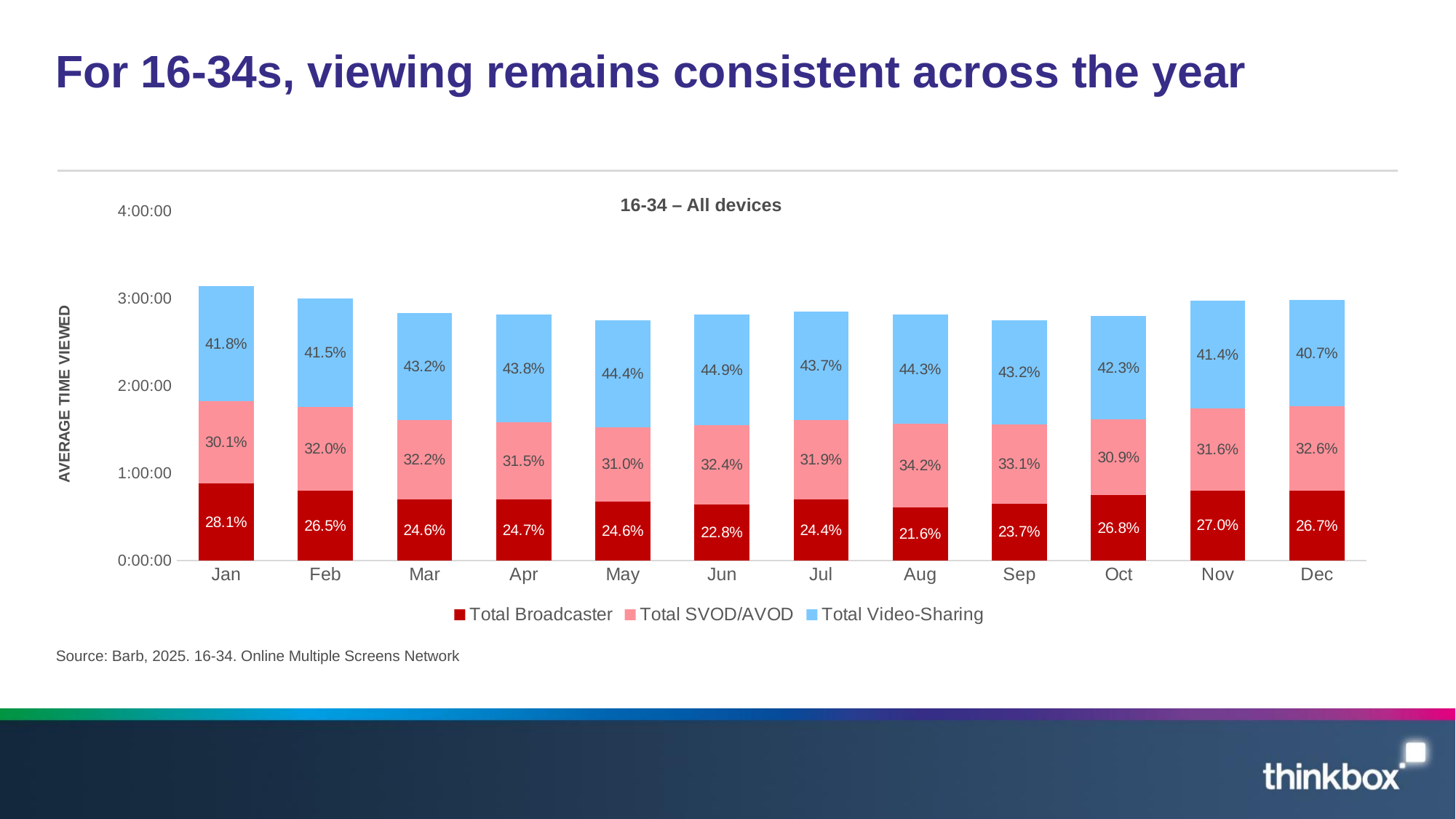
How many series does the legend list? 3 How many months are shown on the x axis? 12 Which month has the lowest Total Broadcaster share label? Aug What kind of chart is shown on the slide? Stacked bar chart Which month has the lowest Total Video-Sharing share label? Dec Which month has the larger Total SVOD/AVOD share, Feb or Oct? Feb What is the difference in percentage points between the Total Broadcaster share in Jan and in Aug? 6.5 percentage points What is the Total Broadcaster share shown for Jan? 28.1% What is the Total Video-Sharing share shown for Jun? 44.9% What is the Total SVOD/AVOD share shown for Aug? 34.2% Which month has the highest Total Broadcaster share label? Jan Is the total bar height for Jan greater or less than 3:00:00? greater